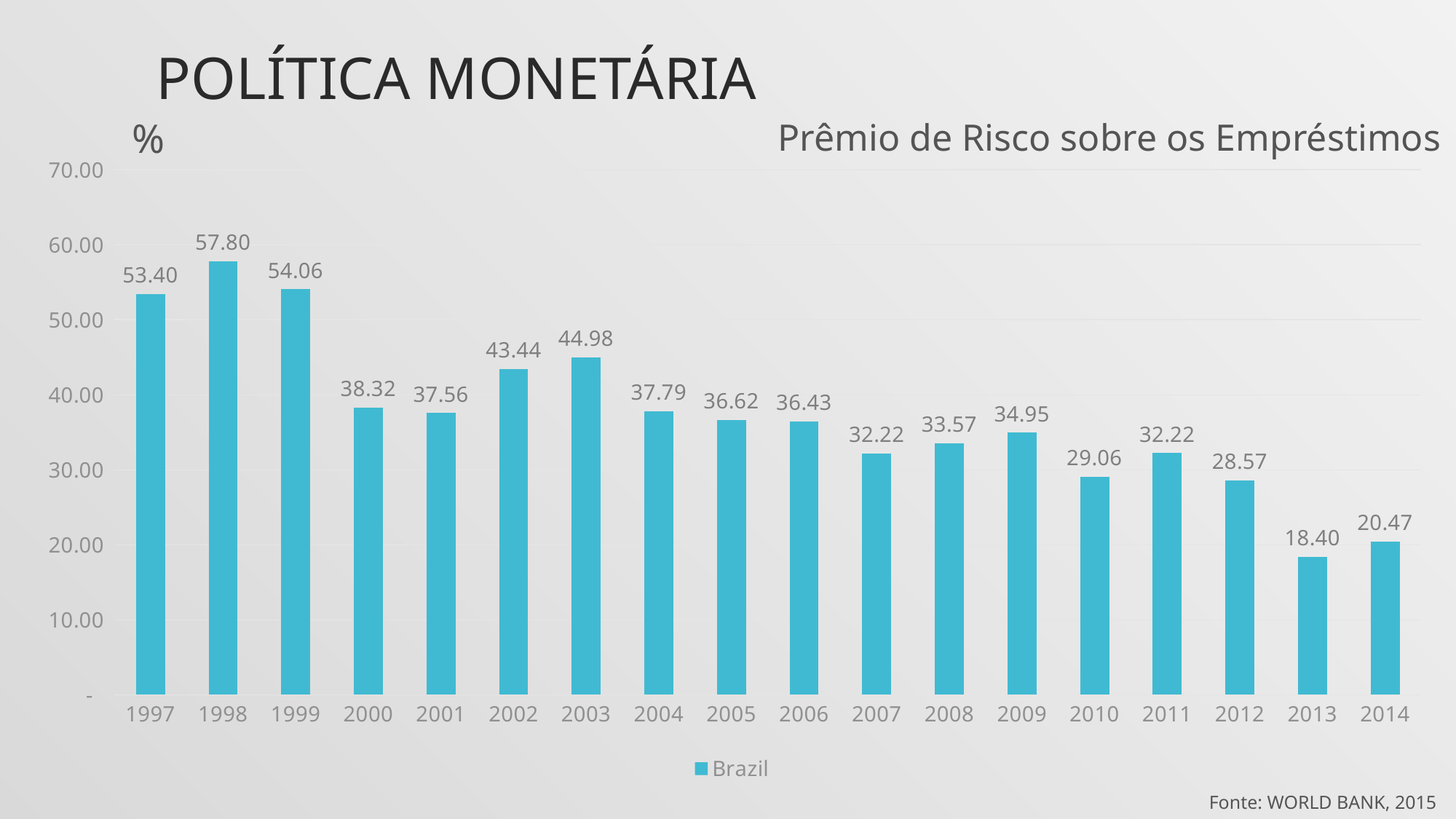
Which year has the highest value? 1998 What kind of chart is shown? bar chart Which year has the lowest value? 2013 What is the value for 2003? 44.98 Is the value for 2010 greater or less than 30.00? less How many series does the legend list? 1 What is the value for 1998? 57.80 What is the difference between the values for 1997 and 2014? 32.93 What is the value for 2013? 18.40 How many years are shown on the x axis? 18 Which is larger, the value for 2002 or the value for 2004? 2002 What is the chart's title? Prêmio de Risco sobre os Empréstimos